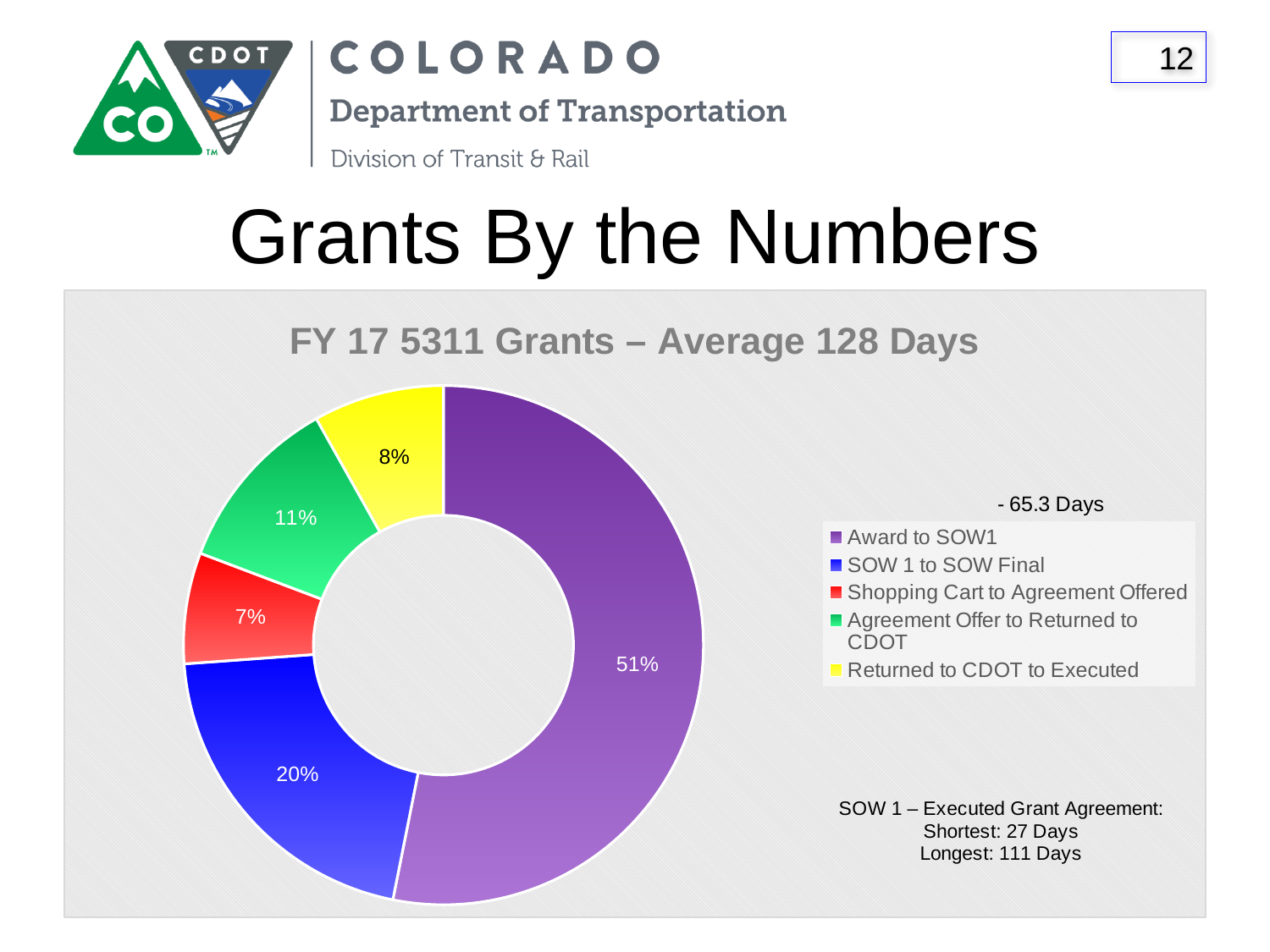
What percentage of the chart is Returned to CDOT to Executed? 8% What percentage of the chart is Award to SOW1? 51% What kind of chart is shown on the slide? Doughnut (pie) chart Which category has the largest share of the chart? Award to SOW1 What percentage of the chart is Shopping Cart to Agreement Offered? 7% What is the title of the chart? FY 17 5311 Grants – Average 128 Days Which is larger: Agreement Offer to Returned to CDOT or Returned to CDOT to Executed? Agreement Offer to Returned to CDOT How many categories does the legend list? 5 Which category has the smallest share of the chart? Shopping Cart to Agreement Offered What percentage of the chart is SOW 1 to SOW Final? 20% What percentage of the chart is Agreement Offer to Returned to CDOT? 11% What is the difference in percentage points between Award to SOW1 and SOW 1 to SOW Final? 31